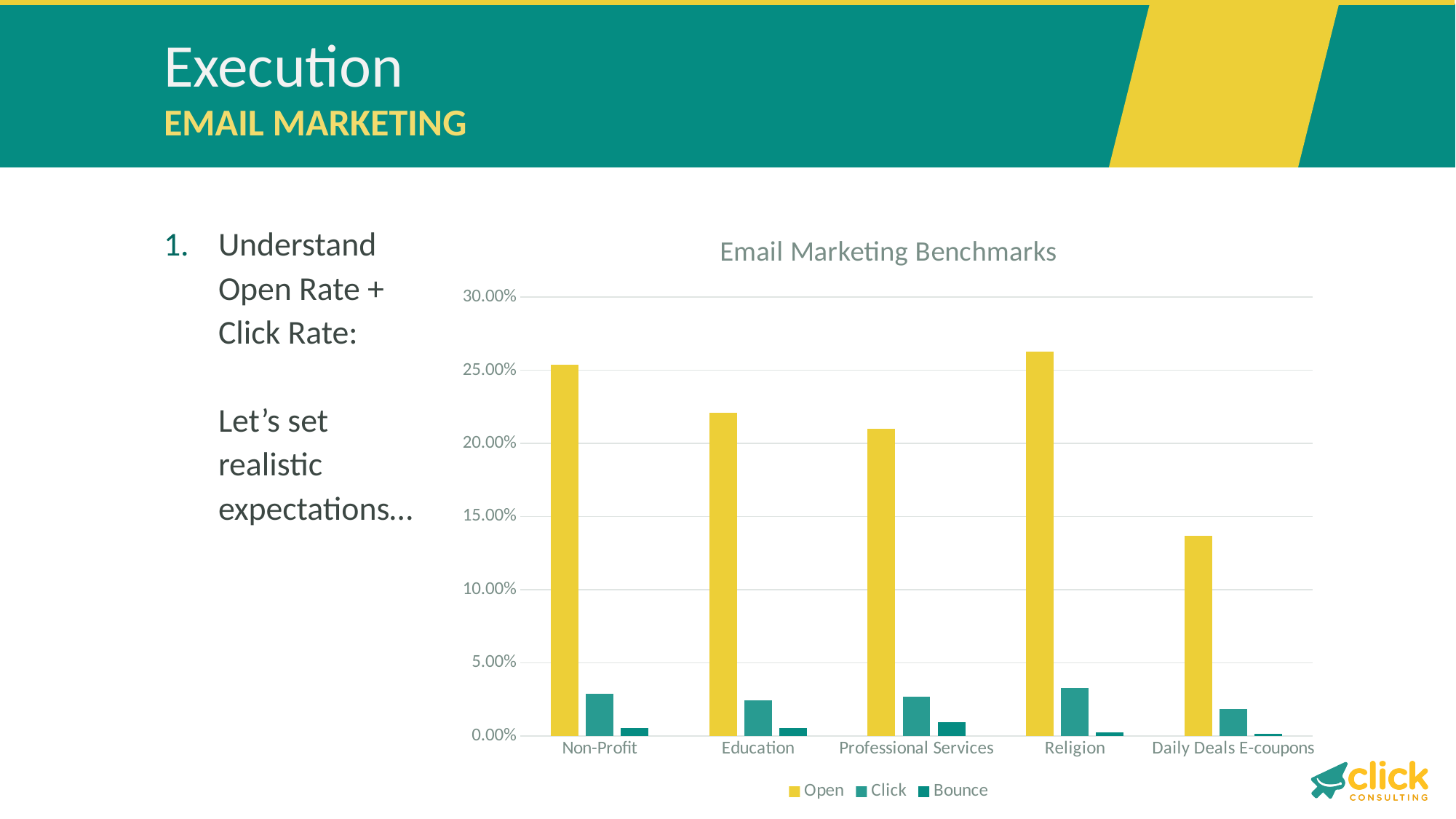
How many categories are shown on the x axis? 5 Which category has the lowest Open value? Daily Deals E-coupons Which is larger, the Open value for Non-Profit or the Open value for Education? Non-Profit Which category has the highest Click value? Religion Is the Open value for Religion greater or less than 25.00%? greater Is the Open value for Daily Deals E-coupons greater or less than 15.00%? less How many series does the legend list? 3 Which category has the highest Bounce value? Professional Services Is the Open value for Education greater or less than 20.00%? greater What is the title of the chart? Email Marketing Benchmarks Which category has the highest Open value? Religion What type of chart is shown on the slide? Bar chart